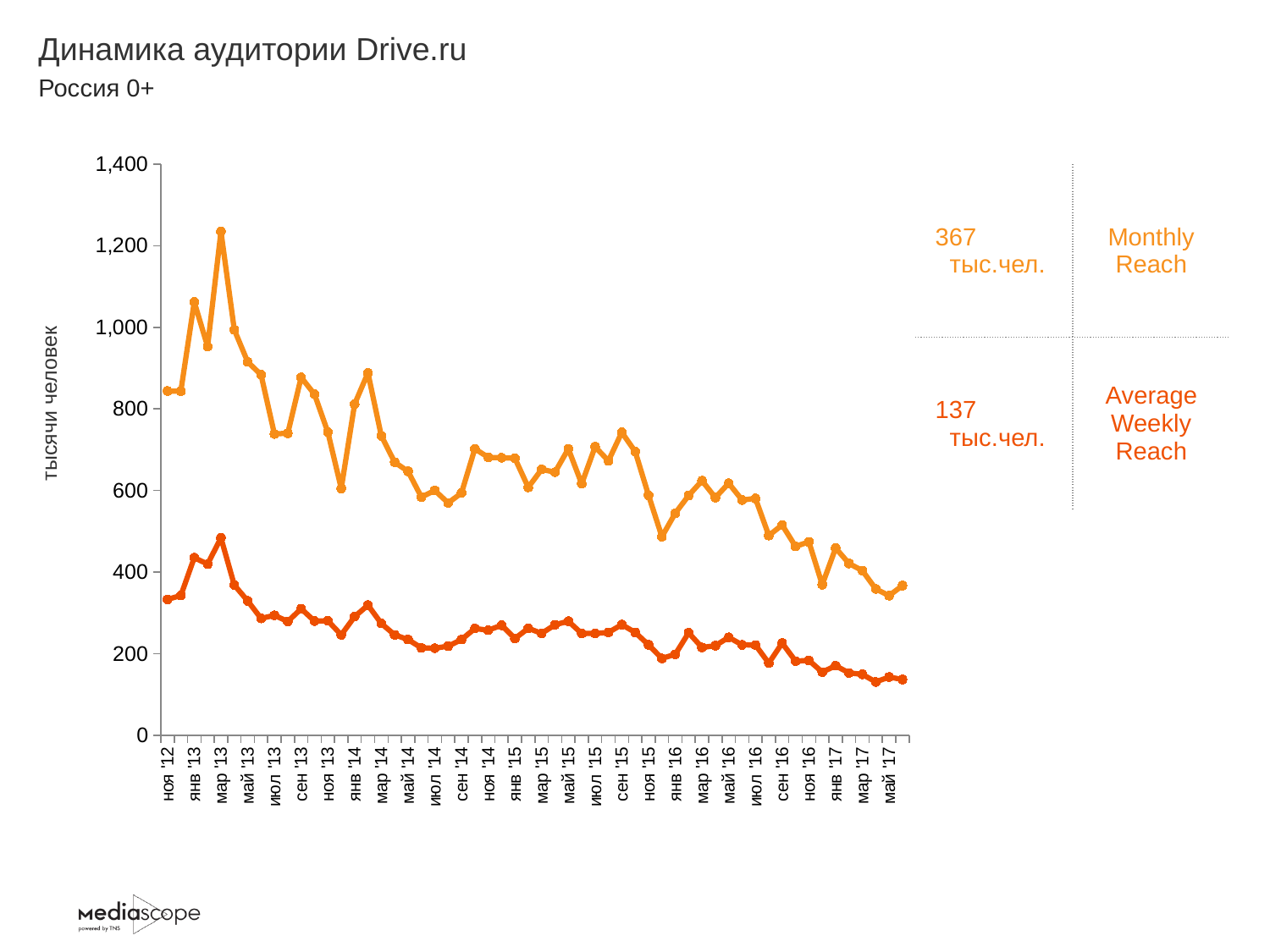
Does the Monthly Reach line generally rise or fall from ноя '12 to май '17? fall How many lines (series) are plotted on the chart? 2 Is the Monthly Reach value at мар '13 greater or less than 1,200? greater What is the label on the vertical axis of the chart? тысячи человек What is the latest Average Weekly Reach value shown on the slide? 137 тыс.чел. What is the difference between the Monthly Reach (367 тыс.чел.) and the Average Weekly Reach (137 тыс.чел.) shown on the slide? 230 тыс.чел. Is the Average Weekly Reach value at май '17 greater or less than 200? less Which line is higher throughout the chart, Monthly Reach or Average Weekly Reach? Monthly Reach What kind of chart is shown on the slide? line chart What is the latest Monthly Reach value shown on the slide? 367 тыс.чел. What is the title of the chart on the slide? Динамика аудитории Drive.ru In which month does the Monthly Reach line reach its highest point? мар '13